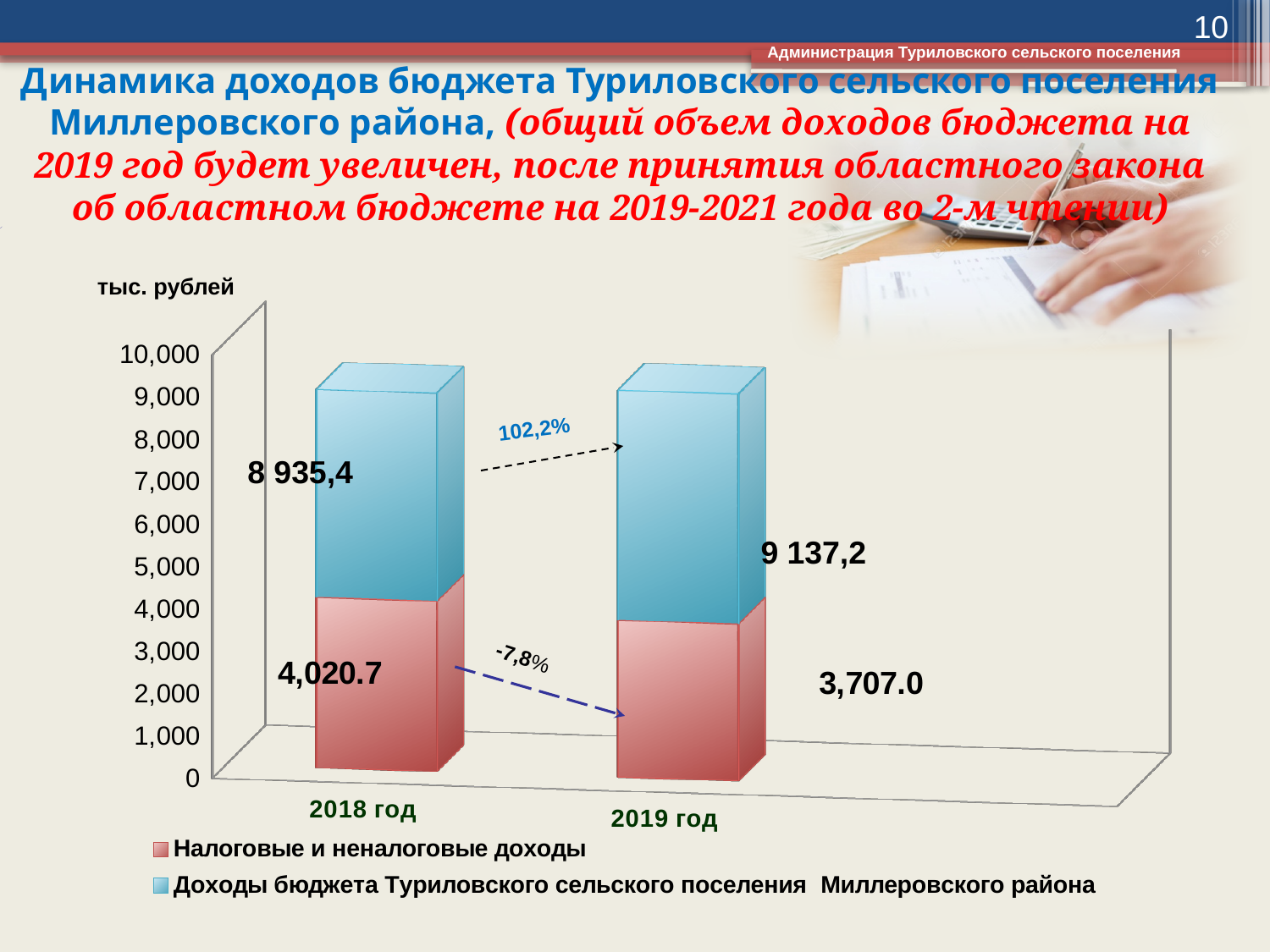
What is the value labelled for Налоговые и неналоговые доходы in 2019 год? 3,707.0 What is the value labelled for Налоговые и неналоговые доходы in 2018 год? 4,020.7 What is the value labelled for Доходы бюджета Туриловского сельского поселения Миллеровского района in 2018 год? 8 935,4 By how much does the value for Налоговые и неналоговые доходы in 2018 год exceed the value in 2019 год? 313.7 How many series does the legend list? 2 Does the value for Налоговые и неналоговые доходы fall or rise from 2018 год to 2019 год? fall How many years (categories) are shown on the x axis? 2 What is the value labelled for Доходы бюджета Туриловского сельского поселения Миллеровского района in 2019 год? 9 137,2 Which year has the higher value for Налоговые и неналоговые доходы, 2018 год or 2019 год? 2018 год What kind of chart is shown on the slide? bar chart What percentage change is written next to the dashed arrow between the Налоговые и неналоговые доходы segments? -7,8% Which year has the higher value for Доходы бюджета Туриловского сельского поселения Миллеровского района? 2019 год